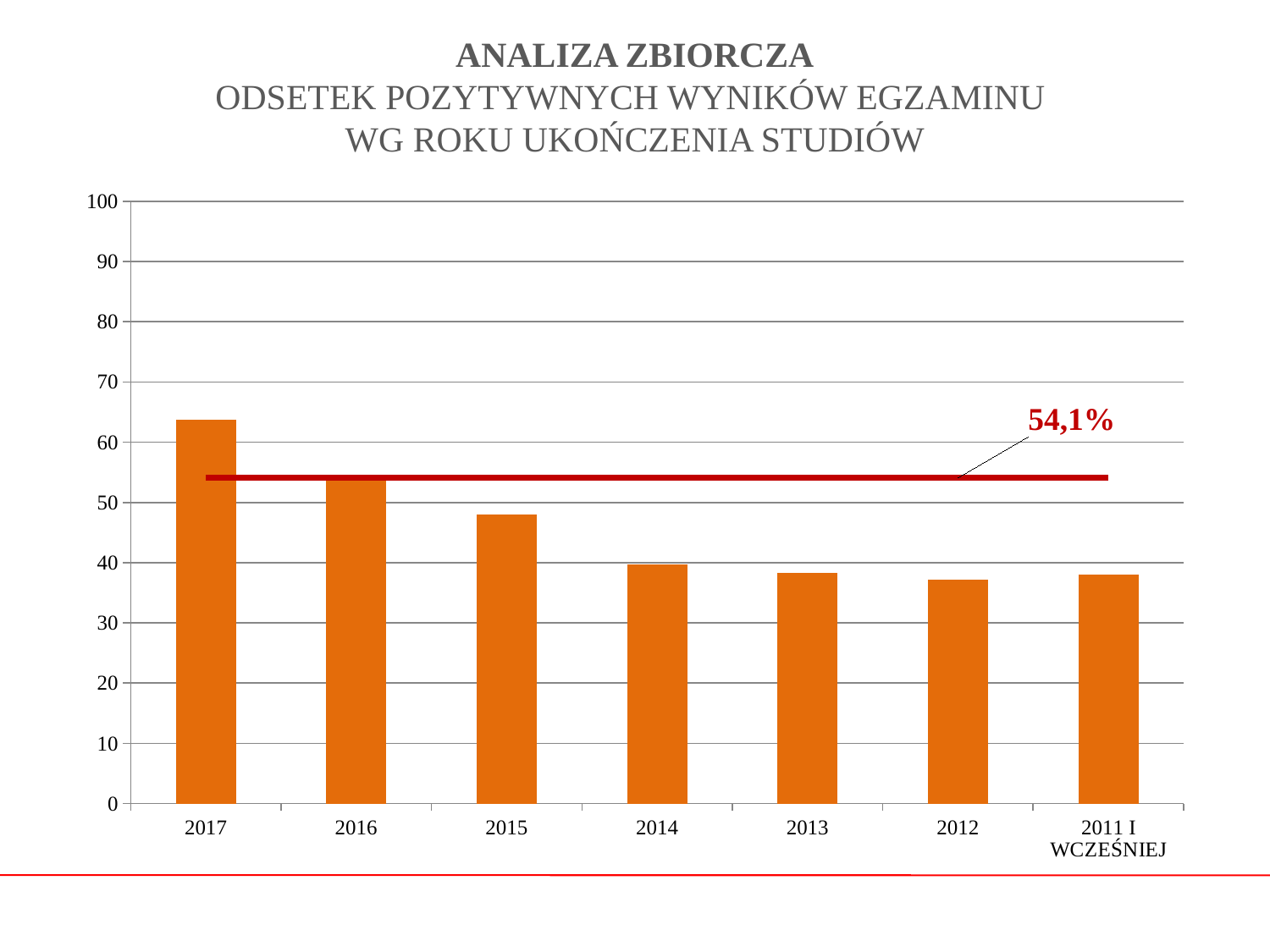
What value is labelled on the horizontal red line drawn across the chart? 54,1% Which year has the highest percentage of positive exam results? 2017 Is the value for 2013 greater or less than 40? less Is the value for 2012 greater or less than 40? less Is the value for 2017 greater or less than 60? greater Which is larger, the value for 2015 or the value for 2014? 2015 What kind of chart is shown on the slide? bar chart How many categories (years) are shown on the x axis? 7 Which is larger, the value for 2017 or the value for 2016? 2017 Do the bar values generally rise or fall moving from 2017 to 2011 I WCZEŚNIEJ along the x axis? fall